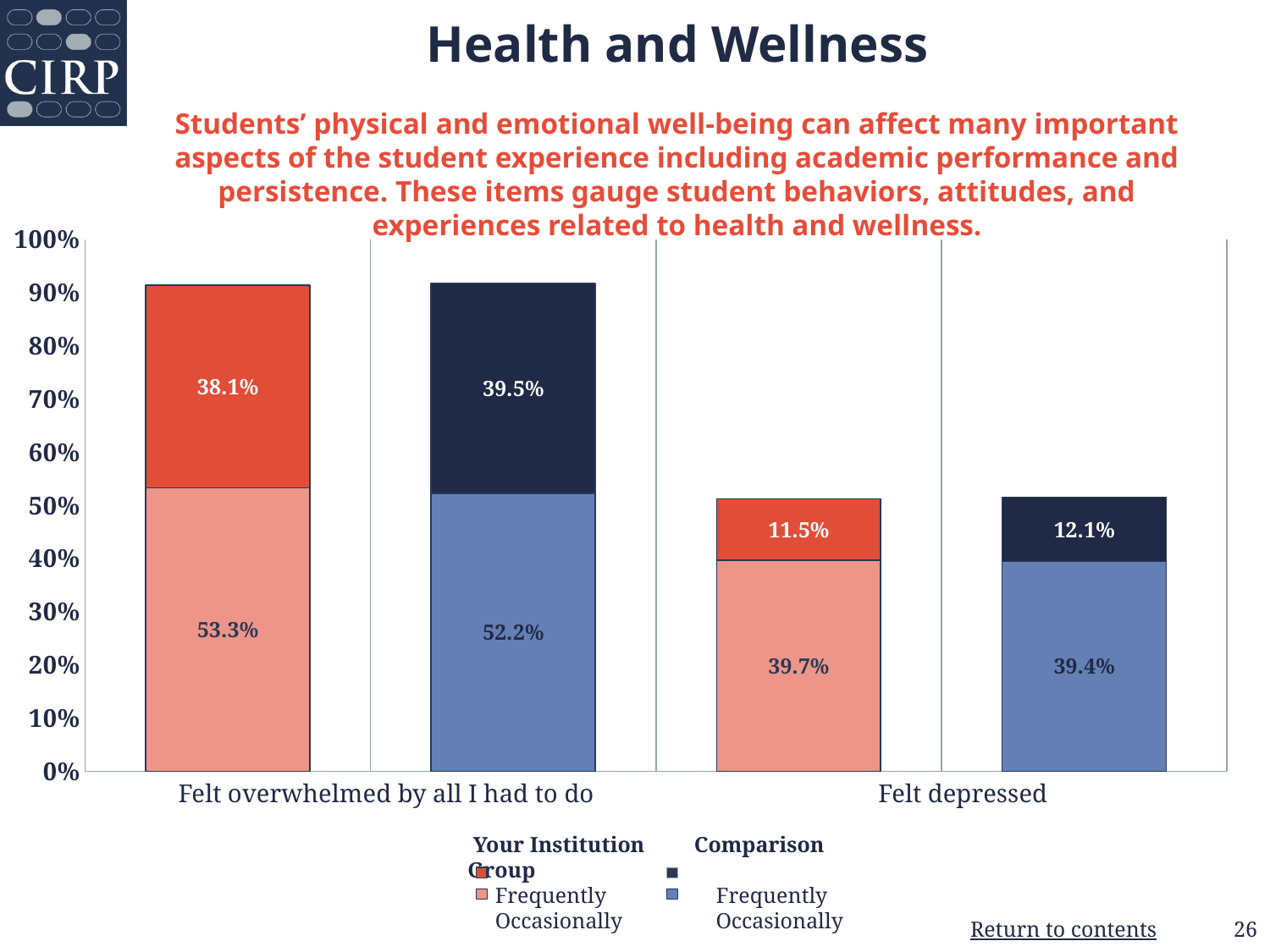
Which is larger: the percentage of Your Institution students who occasionally felt depressed or the percentage who frequently felt depressed? Occasionally (39.7%) What is the difference between the Comparison Group and Your Institution percentages for frequently feeling overwhelmed by all they had to do? 1.4% What percentage of students at Your Institution reported frequently feeling overwhelmed by all they had to do? 38.1% What percentage of students in the Comparison Group reported frequently feeling depressed? 12.1% What percentage of students in the Comparison Group reported occasionally feeling depressed? 39.4% What is the total percentage of Your Institution students who felt overwhelmed by all they had to do (frequently plus occasionally)? 91.4% What is the total percentage of Comparison Group students who felt depressed (frequently plus occasionally)? 51.5% Which item has the lowest 'Frequently' percentage for Your Institution? Felt depressed How many items (categories) are shown on the x axis of the chart? 2 How many series does the chart legend list? 4 What percentage of students at Your Institution reported occasionally feeling overwhelmed by all they had to do? 53.3% What type of chart is shown on the slide? Stacked bar chart